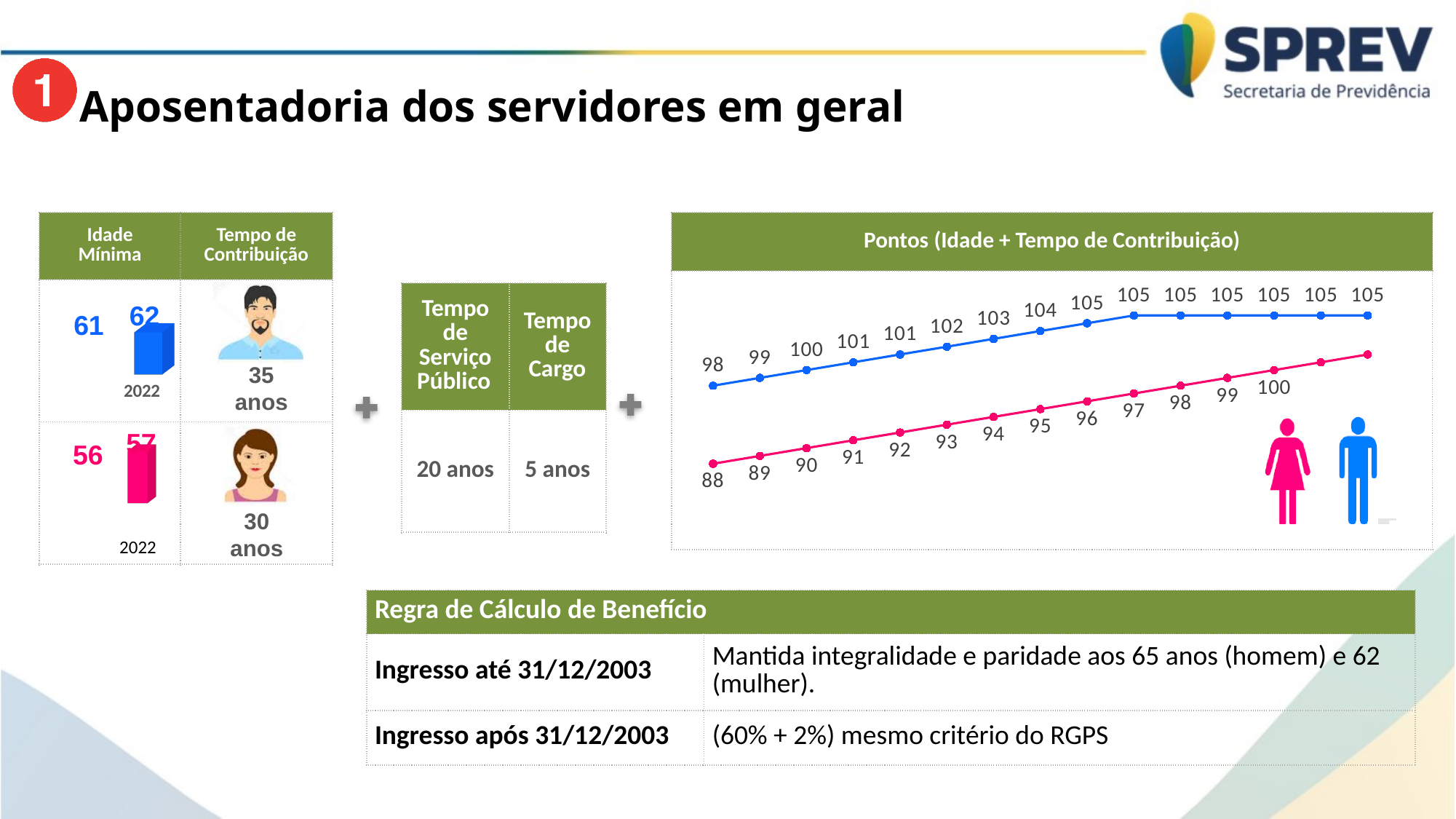
In the 'Pontos' chart, how many points on the blue line are labelled 105? 7 In the 'Pontos' chart, what is the difference between the first point of the blue line (98) and the first point of the pink line (88)? 10 In the 'Pontos' chart, what is the lowest value on the pink line? 88 In the 'Pontos' chart, what is the value of the first point on the pink line? 88 In the 'Pontos' chart, what is the highest value reached by the blue line? 105 What is the title of the line chart on the right side of the slide? Pontos (Idade + Tempo de Contribuição) In the 'Pontos' chart, what is the value of the first point on the blue line? 98 In the 'Pontos' chart, how many data points does the blue line have? 15 How many lines (series) are plotted in the 'Pontos' chart? 2 In the 'Pontos' chart, which line is higher throughout, the blue line or the pink line? the blue line What kind of chart is shown under the title 'Pontos (Idade + Tempo de Contribuição)'? line chart In the 'Pontos' chart, do the values of the pink line rise or fall from left to right? rise